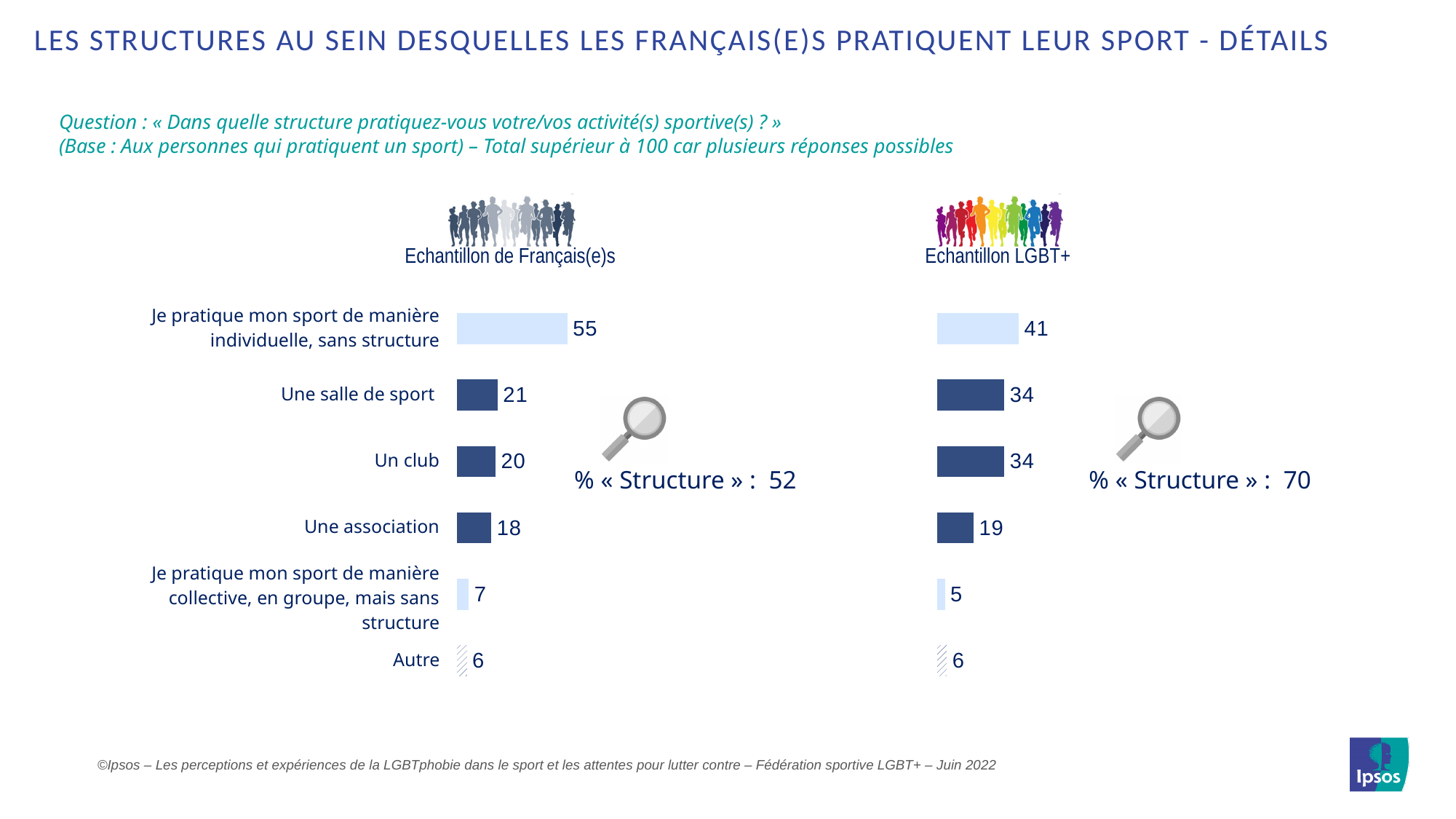
In the 'Echantillon de Français(e)s' chart, what is the value for 'Une salle de sport'? 21 What is the '% « Structure »' figure shown next to the 'Echantillon LGBT+' chart? 70 In the 'Echantillon LGBT+' chart, what is the difference between 'Une salle de sport' and 'Une association'? 15 What kind of chart is the 'Echantillon LGBT+' chart? Bar chart In the 'Echantillon LGBT+' chart, what is the value for 'Une association'? 19 How many categories does the 'Echantillon de Français(e)s' chart show? 6 In the 'Echantillon de Français(e)s' chart, what is the difference between 'Je pratique mon sport de manière individuelle, sans structure' and 'Une salle de sport'? 34 In the 'Echantillon LGBT+' chart, what is the value for 'Je pratique mon sport de manière individuelle, sans structure'? 41 In the 'Echantillon LGBT+' chart, which category has the lowest value? Je pratique mon sport de manière collective, en groupe, mais sans structure Which is larger: the value for 'Un club' in the 'Echantillon de Français(e)s' chart or in the 'Echantillon LGBT+' chart? Echantillon LGBT+ What is the '% « Structure »' figure shown next to the 'Echantillon de Français(e)s' chart? 52 In the 'Echantillon de Français(e)s' chart, which category has the highest value? Je pratique mon sport de manière individuelle, sans structure